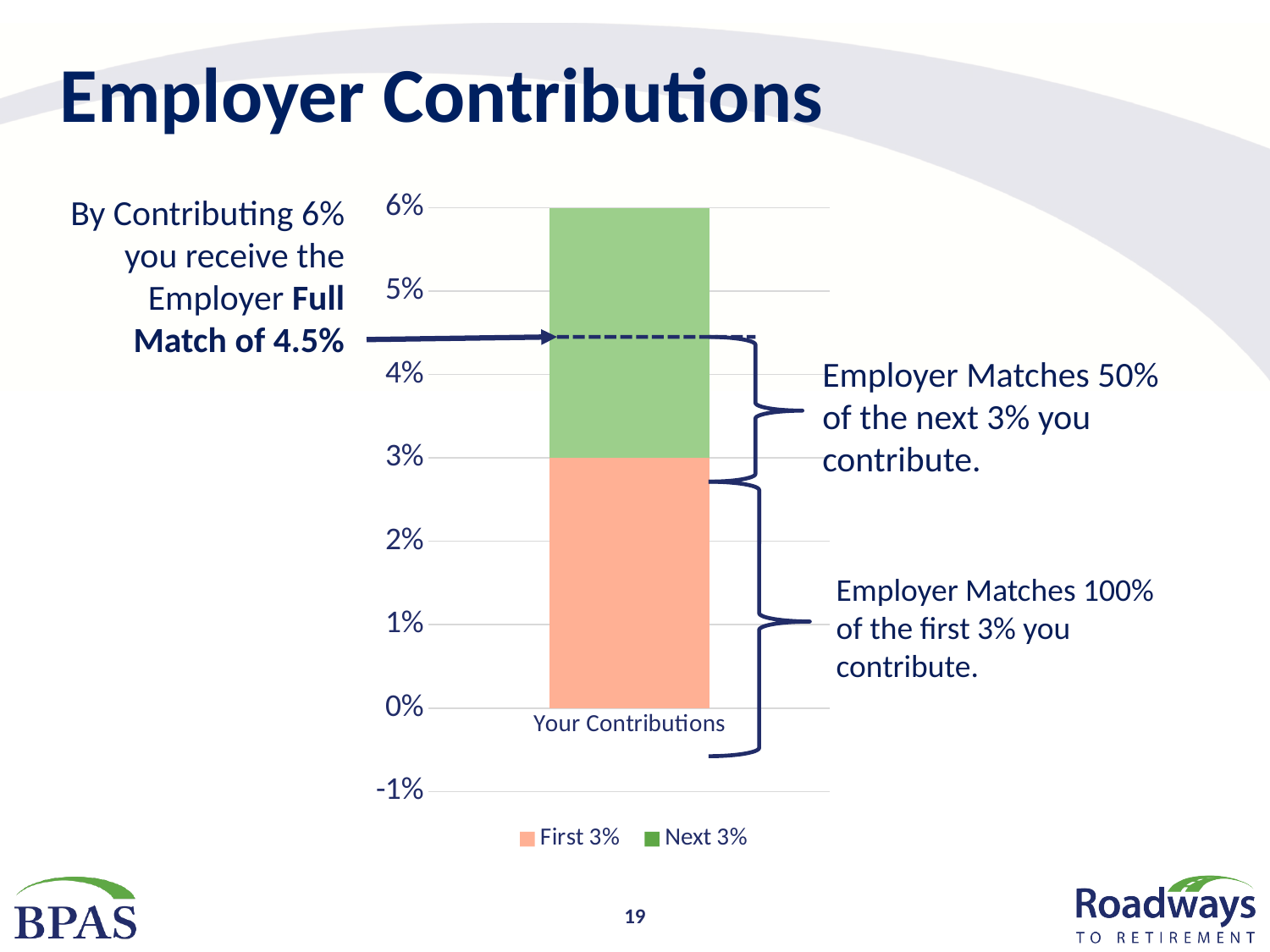
What is the difference between the First 3% and Next 3% segment values? 0% What is the lowest value shown on the chart's y axis? -1% What is the value of the Next 3% segment for Your Contributions? 3% How many series does the chart legend list? 2 What is the total height of the stacked bar for Your Contributions? 6% Is the top of the First 3% segment greater or less than 4%? less What is the label of the category on the x axis? Your Contributions What are the two series named in the chart legend? First 3% and Next 3% What kind of chart is shown on the slide? Stacked bar chart How many categories are shown on the x axis of the chart? 1 What is the value of the First 3% segment for Your Contributions? 3% Is the top of the stacked bar for Your Contributions greater or less than 5%? greater